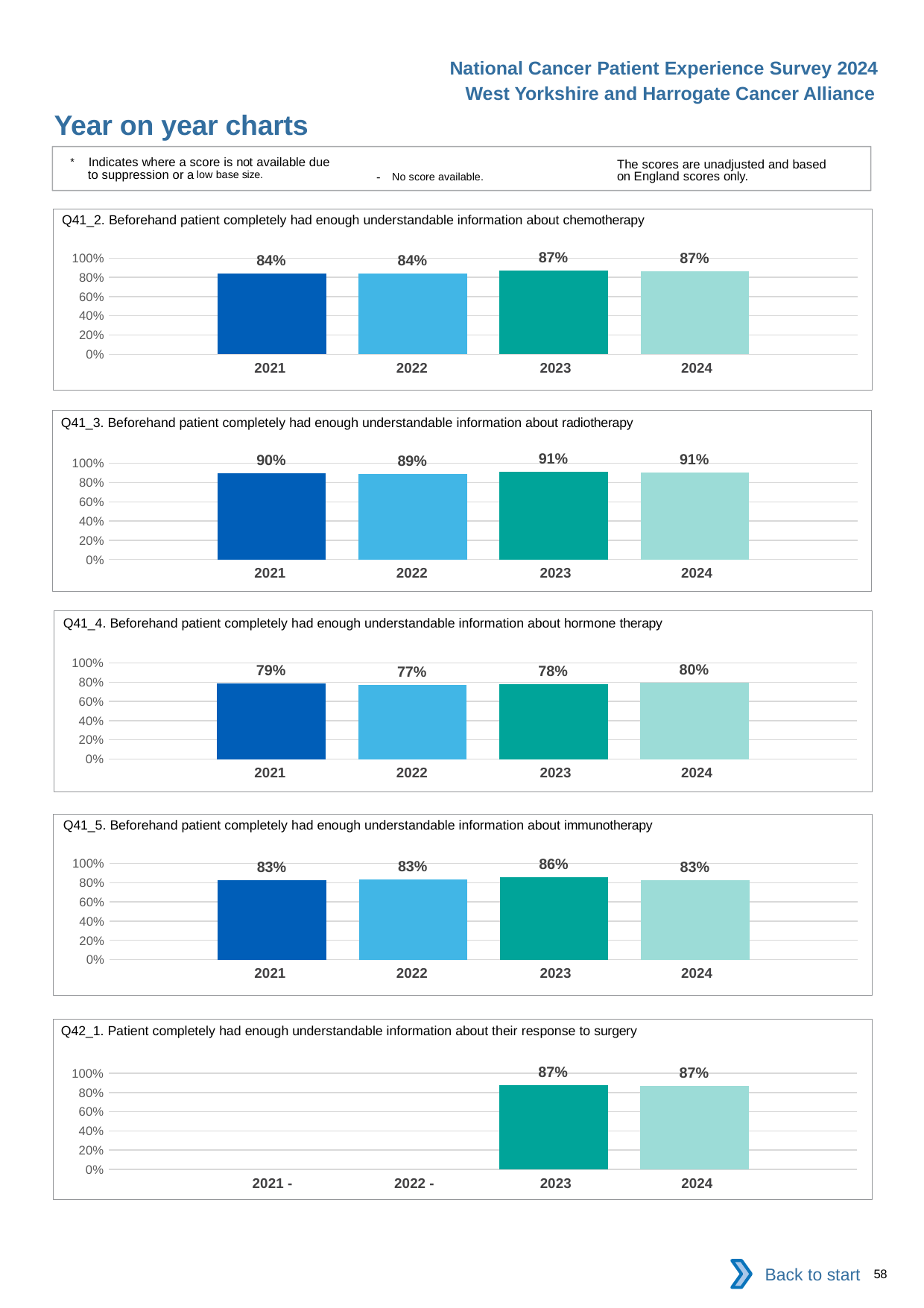
In the Q41_3 radiotherapy chart, which is larger, the value for 2021 or the value for 2022? 2021 In the Q41_3 radiotherapy chart, what is the value for 2022? 89% In the Q41_2 chemotherapy chart, what is the value for 2021? 84% In the Q41_2 chemotherapy chart, do the values rise or fall from 2022 to 2023? Rise In the Q42_1 surgery chart, how many years have a bar plotted? 2 In the Q41_4 hormone therapy chart, which year has the lowest value? 2022 In the Q42_1 surgery chart, what is the value for 2024? 87% What kind of chart is the Q41_2 chemotherapy chart? Bar chart How many charts are shown on the slide? 5 In the Q41_5 immunotherapy chart, which year has the highest value? 2023 In the Q41_4 hormone therapy chart, which year has the highest value? 2024 In the Q41_5 immunotherapy chart, what is the difference between the 2023 value and the 2024 value? 3 percentage points